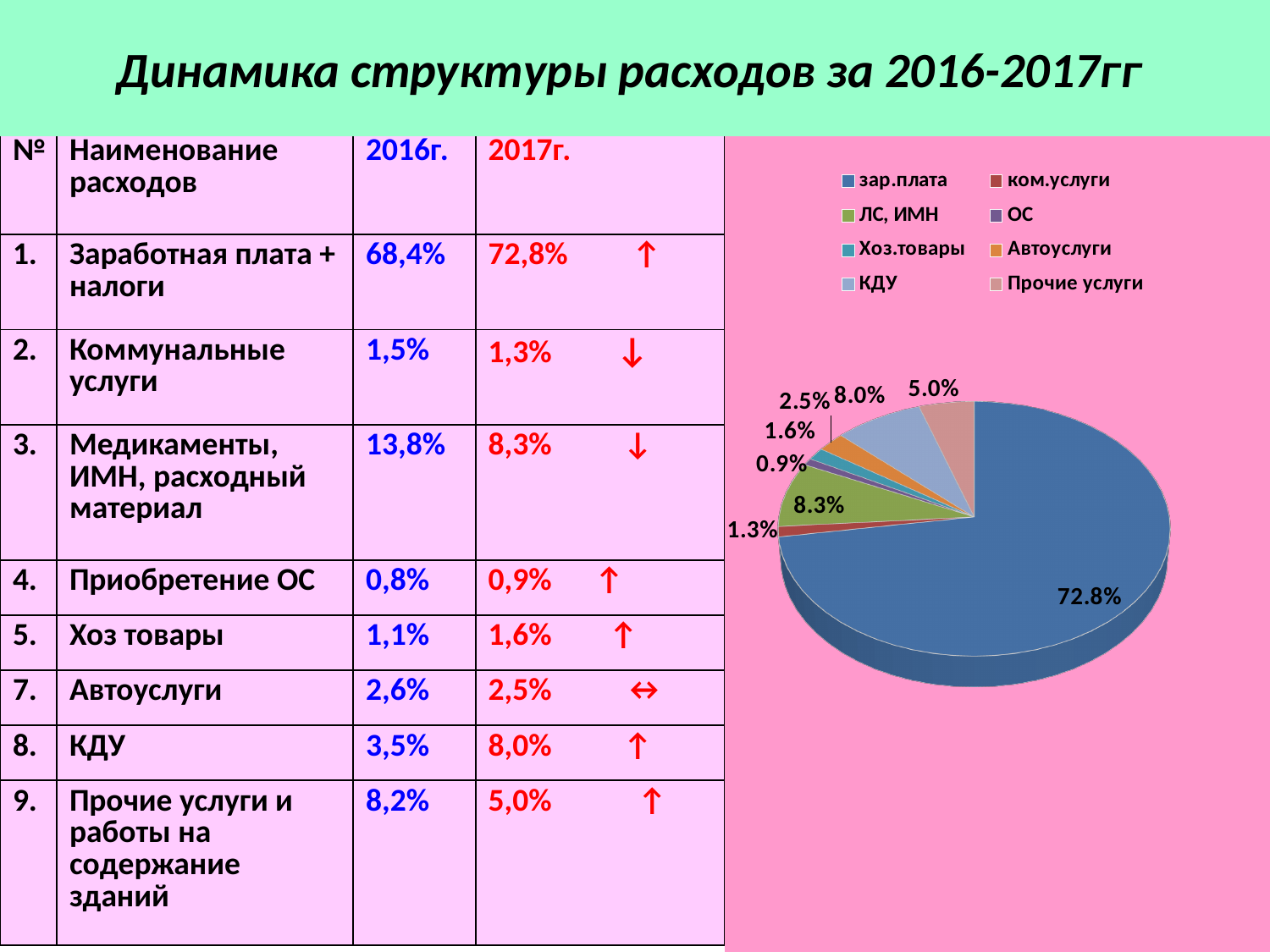
What share of the pie chart does Прочие услуги have? 5.0% What kind of chart is shown on the slide? pie chart How many slices does the pie chart have? 8 What is the difference between the shares of ЛС, ИМН and КДУ in the pie chart? 0.3% Which category has the largest slice in the pie chart? зар.плата What share of the pie chart does Автоуслуги have? 2.5% What share of the pie chart does ЛС, ИМН have? 8.3% How many entries does the pie chart legend list? 8 Which slice is larger in the pie chart, Хоз.товары or ком.услуги? Хоз.товары Which category has the smallest slice in the pie chart? ОС What share of the pie chart does КДУ have? 8.0% What share of the pie chart does зар.плата have? 72.8%